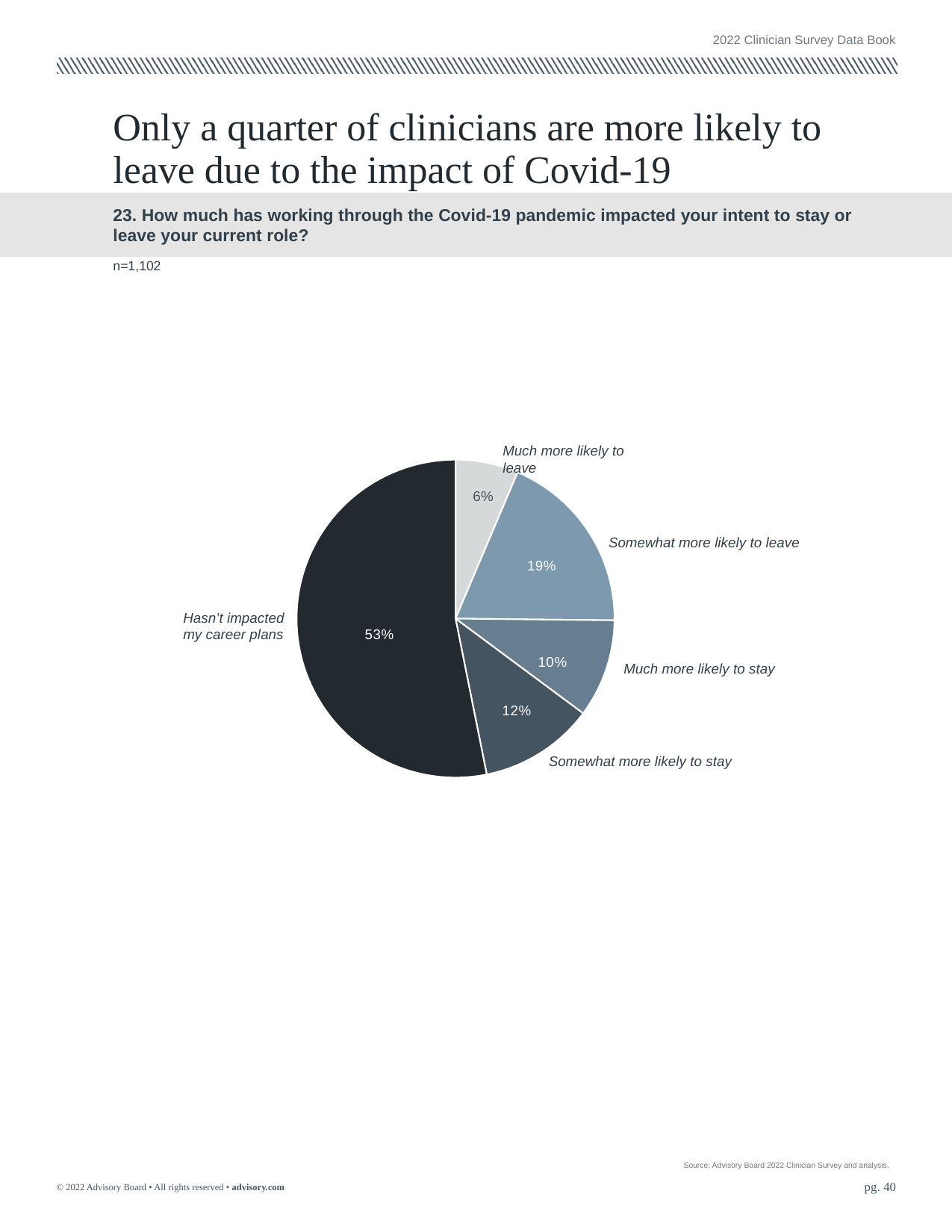
Which response has the largest slice of the pie? Hasn't impacted my career plans What percentage of clinicians are much more likely to stay? 10% Which response has the smallest slice of the pie? Much more likely to leave Which is larger: the share somewhat more likely to stay or the share much more likely to stay? Somewhat more likely to stay What percentage of clinicians are much more likely to leave? 6% What percentage of clinicians are somewhat more likely to leave? 19% What share of clinicians said working through the pandemic hasn't impacted their career plans? 53% What percentage of clinicians are somewhat more likely to stay? 12% How many slices does the pie chart have? 5 What is the sample size (n) shown for this survey question? n=1,102 What is the difference in percentage points between 'Somewhat more likely to leave' and 'Much more likely to leave'? 13 percentage points What type of chart is shown on the slide? Pie chart